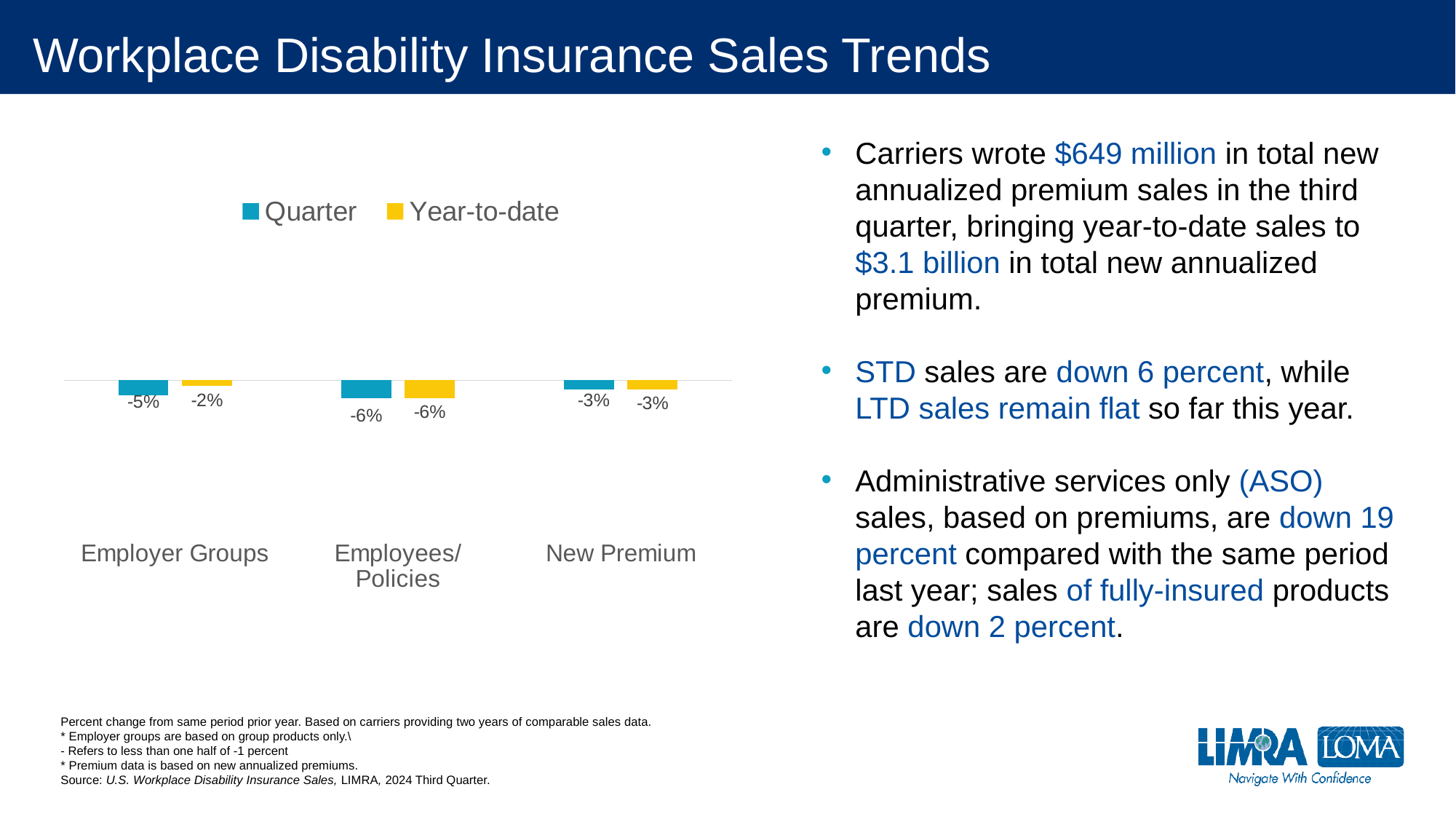
Which category has the highest Year-to-date value? Employer Groups What is the Year-to-date value for New Premium? -3% What is the Quarter value for Employees/Policies? -6% What is the difference between the Quarter and Year-to-date values for Employer Groups? 3 percentage points Which is larger, the Quarter value for Employer Groups or the Quarter value for New Premium? New Premium How many categories are shown on the x axis? 3 How many series does the legend list? 2 What is the Year-to-date value for Employer Groups? -2% What kind of chart is shown on the slide? Bar chart Which category has the lowest Quarter value? Employees/Policies Which series is shown in yellow in the legend? Year-to-date What is the Quarter value for Employer Groups? -5%